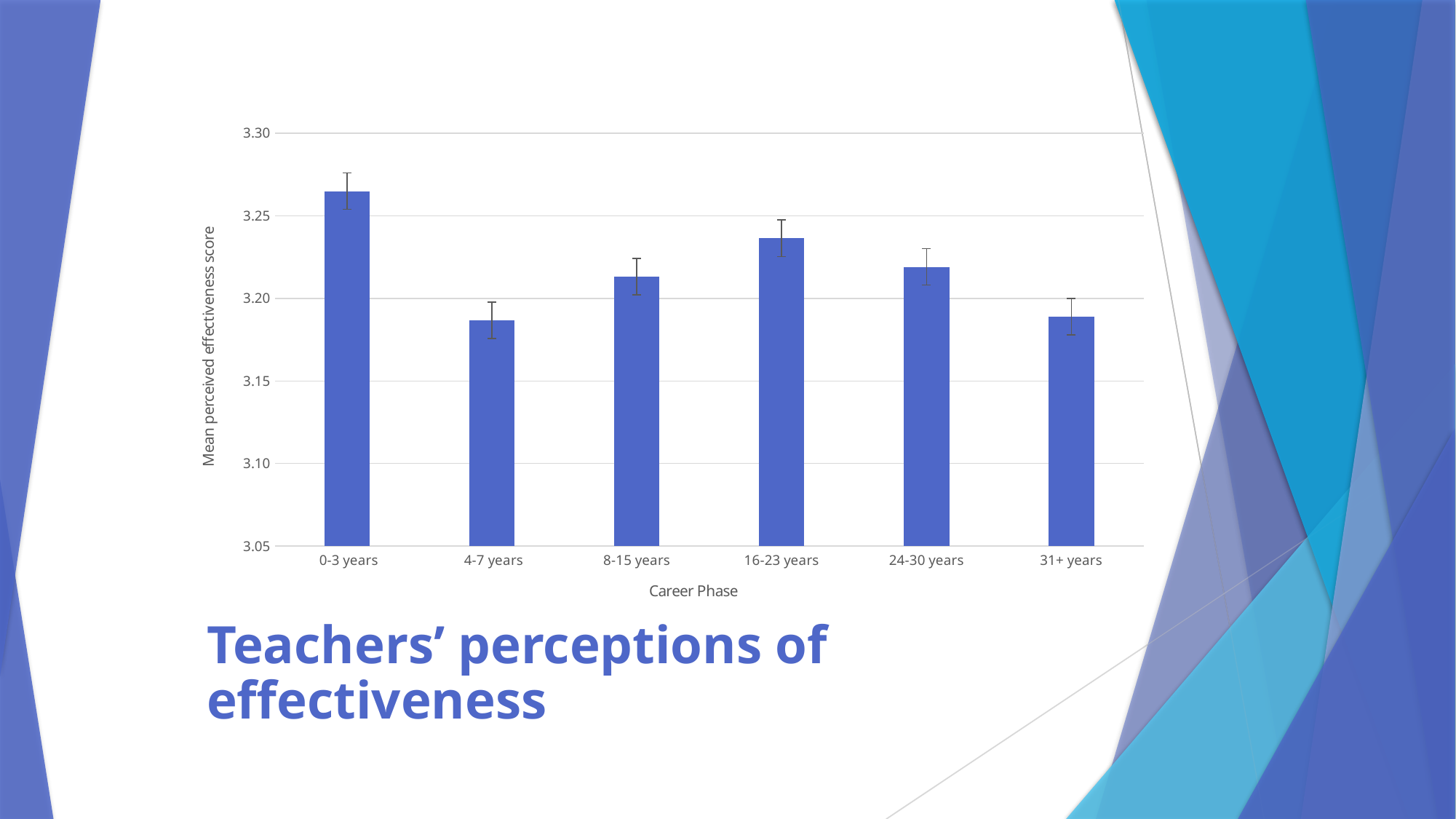
Is the value for 31+ years greater or less than 3.20? less What is the label of the x axis? Career Phase Is the value for 4-7 years greater or less than 3.20? less Is the value for 0-3 years greater or less than 3.25? greater Which career phase has the highest mean perceived effectiveness score? 0-3 years What kind of chart is shown on the slide? bar chart What is the label of the y axis? Mean perceived effectiveness score How many career phase categories are plotted on the chart? 6 Which has a higher mean perceived effectiveness score, 16-23 years or 8-15 years? 16-23 years Which has a higher mean perceived effectiveness score, 0-3 years or 16-23 years? 0-3 years